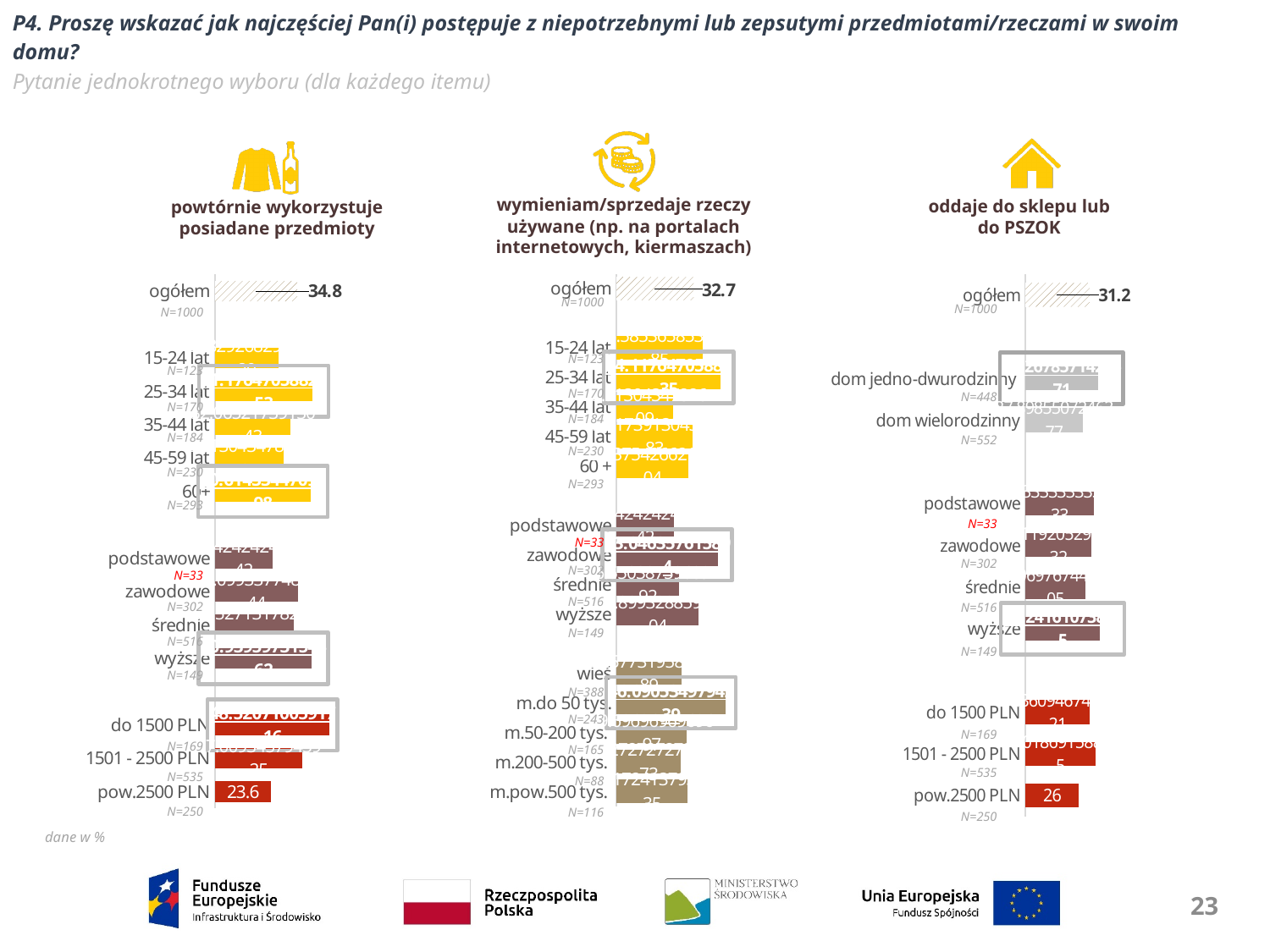
In the chart titled 'powtórnie wykorzystuje posiadane przedmioty', what is the value for 'pow.2500 PLN'? 23.6 In the chart titled 'wymieniam/sprzedaje rzeczy używane', what is the value for 'ogółem'? 32.7 Which chart has the higher 'ogółem' value: 'powtórnie wykorzystuje posiadane przedmioty' or 'wymieniam/sprzedaje rzeczy używane'? powtórnie wykorzystuje posiadane przedmioty In the chart titled 'powtórnie wykorzystuje posiadane przedmioty', how much higher is the 'ogółem' value than the 'pow.2500 PLN' value? 11.2 What is the difference between the 'ogółem' value in the left chart (34.8) and the 'ogółem' value in the right chart (31.2)? 3.6 What kind of chart is used on this slide? bar chart What is the sample size (N) shown for the 'ogółem' bar in each chart? N=1000 In the chart titled 'oddaje do sklepu lub do PSZOK', what is the value for 'pow.2500 PLN'? 26 In the chart titled 'powtórnie wykorzystuje posiadane przedmioty', what is the value for 'ogółem'? 34.8 Is the 'pow.2500 PLN' value larger in the left chart ('powtórnie wykorzystuje posiadane przedmioty') or in the right chart ('oddaje do sklepu lub do PSZOK')? right chart (oddaje do sklepu lub do PSZOK) In the chart titled 'oddaje do sklepu lub do PSZOK', what is the value for 'ogółem'? 31.2 How many categories (bars) are shown in the chart titled 'oddaje do sklepu lub do PSZOK'? 10